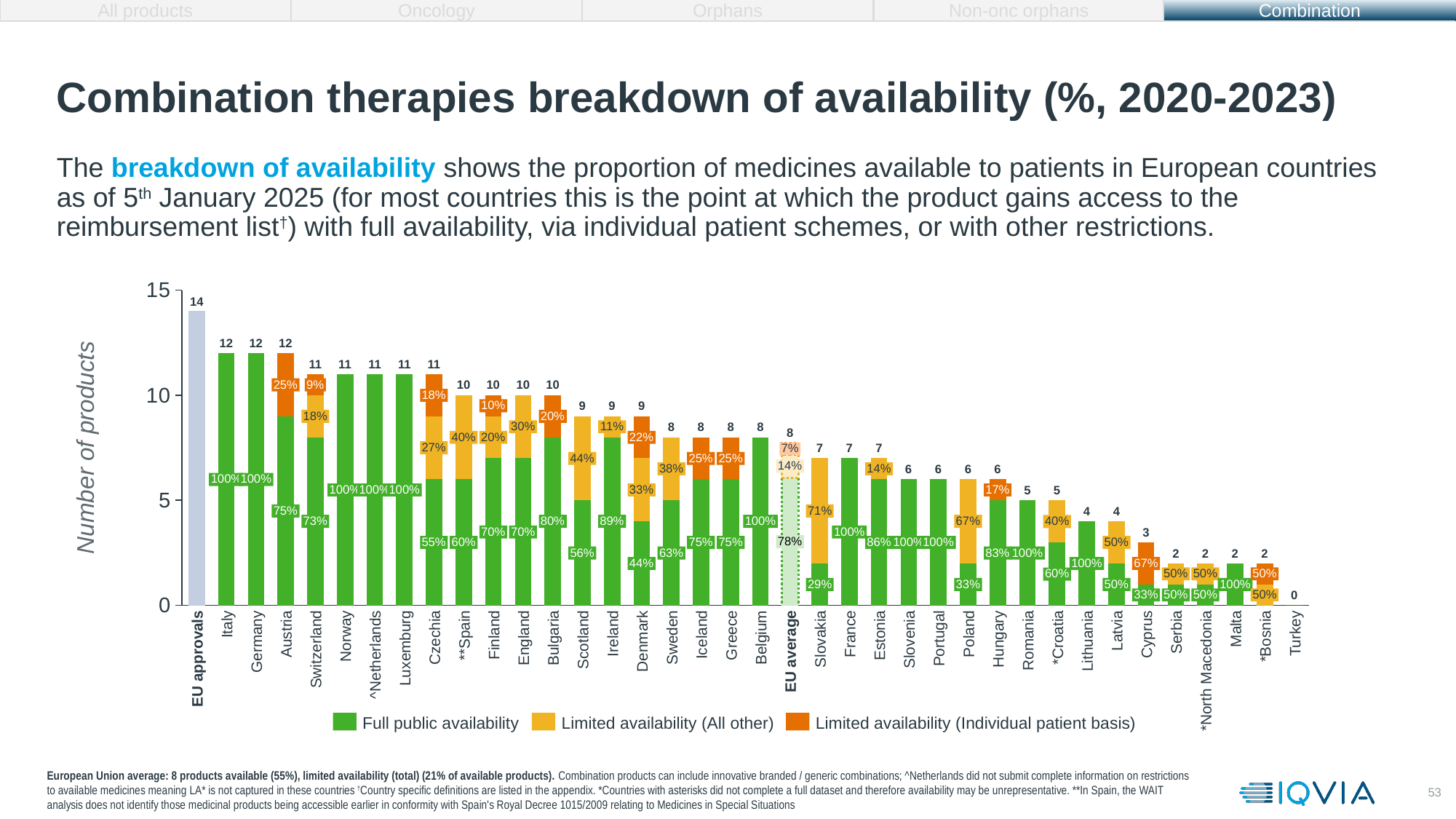
How many series does the legend list? 3 What is the difference in number of products between EU approvals and Italy? 2 Which country has the lowest number of products? Turkey Do the total number of products generally rise or fall moving from left to right along the x axis? Fall What is the total number of products for Czechia? 11 What percentage of Slovakia's products have full public availability? 29% What is the total number of products for the EU average bar? 8 Which colour represents full public availability in the legend? Green Which has more products, Scotland or Sweden? Scotland What kind of chart is shown on the slide? Stacked bar chart Which bar has the highest number of products? EU approvals What percentage of Denmark's products have limited availability on an individual patient basis? 22%